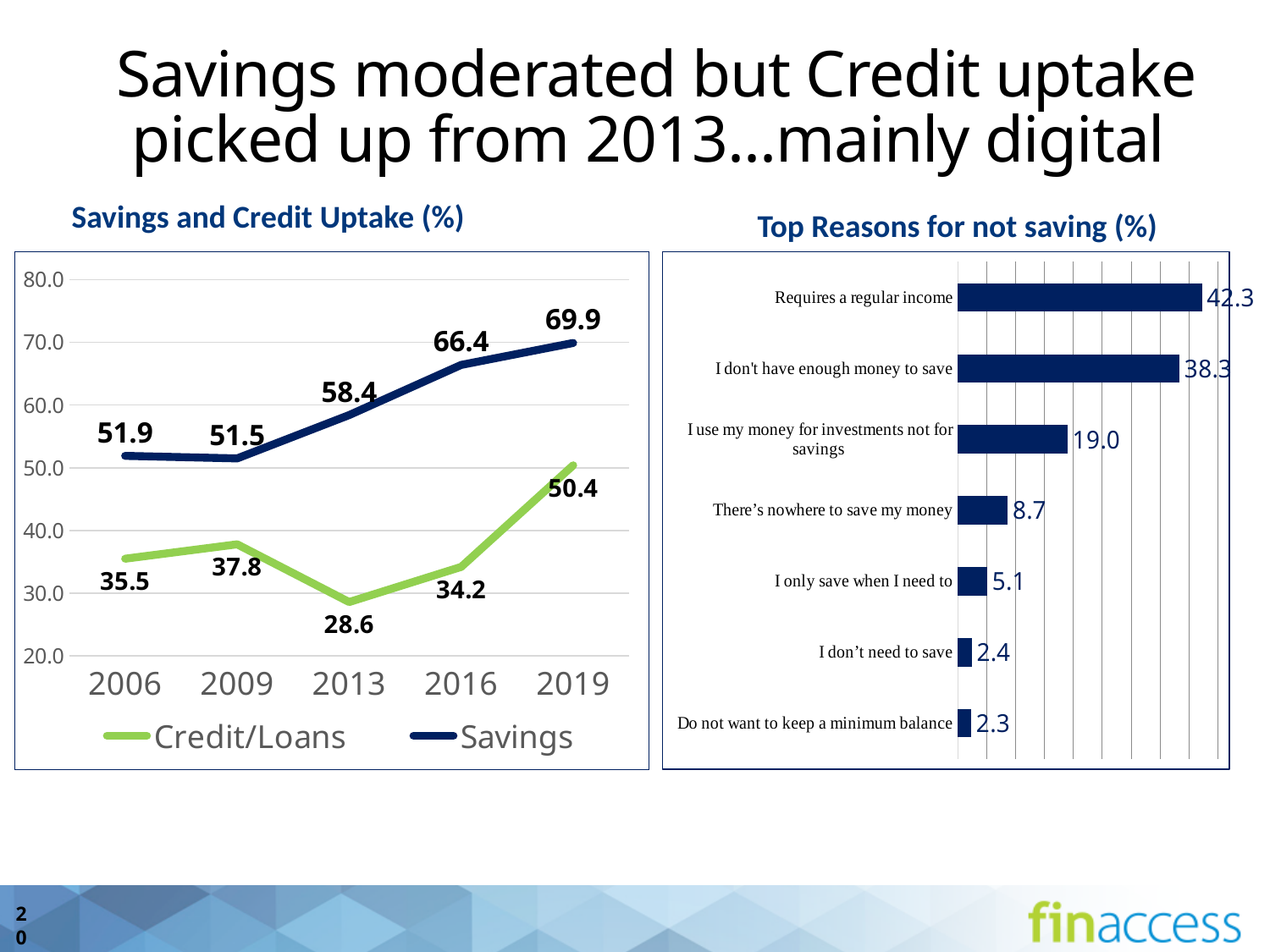
What kind of chart is 'Top Reasons for not saving (%)'? bar chart In the 'Savings and Credit Uptake (%)' chart, what is the Credit/Loans value for 2013? 28.6 In the 'Top Reasons for not saving (%)' chart, what is the value for 'I use my money for investments not for savings'? 19.0 In the 'Savings and Credit Uptake (%)' chart, how many series does the legend list? 2 In the 'Top Reasons for not saving (%)' chart, which reason has the highest value? Requires a regular income In the 'Savings and Credit Uptake (%)' chart, which year has the lowest Credit/Loans value? 2013 In the 'Top Reasons for not saving (%)' chart, what is the difference between 'Requires a regular income' and 'I don't have enough money to save'? 4.0 In the 'Savings and Credit Uptake (%)' chart, what is the difference between the Savings and Credit/Loans values in 2016? 32.2 In the 'Savings and Credit Uptake (%)' chart, what is the Savings value for 2019? 69.9 In the 'Savings and Credit Uptake (%)' chart, how many years are plotted on the x axis? 5 What kind of chart is 'Savings and Credit Uptake (%)'? line chart In the 'Savings and Credit Uptake (%)' chart, does the Savings series rise or fall from 2013 to 2019? rise